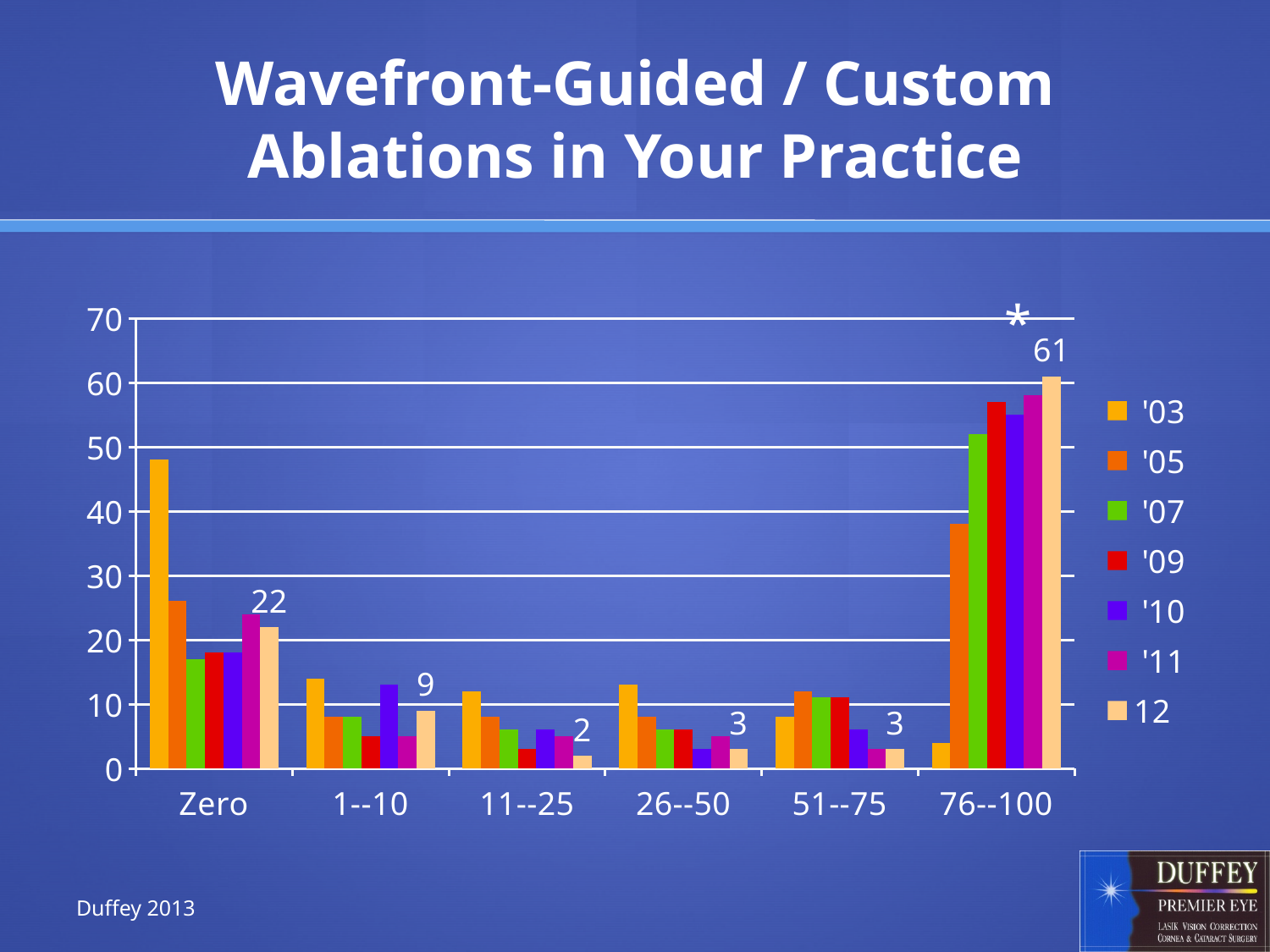
What is the value for the '12 series in the 76--100 category? 61 Is the value for the '03 series in the Zero category greater or less than 40? greater How many categories are shown on the x axis? 6 What is the value for the '12 series in the 1--10 category? 9 Is the value for the '03 series in the 76--100 category greater or less than 10? less How many series does the legend list? 7 What is the value for the '12 series in the 11--25 category? 2 In which category is the '12 series lowest? 11--25 What is the value for the '12 series in the Zero category? 22 In which category is the '12 series highest? 76--100 What is the difference between the '12 values for 76--100 and Zero? 39 Which is larger for the '12 series: the Zero category or the 1--10 category? Zero